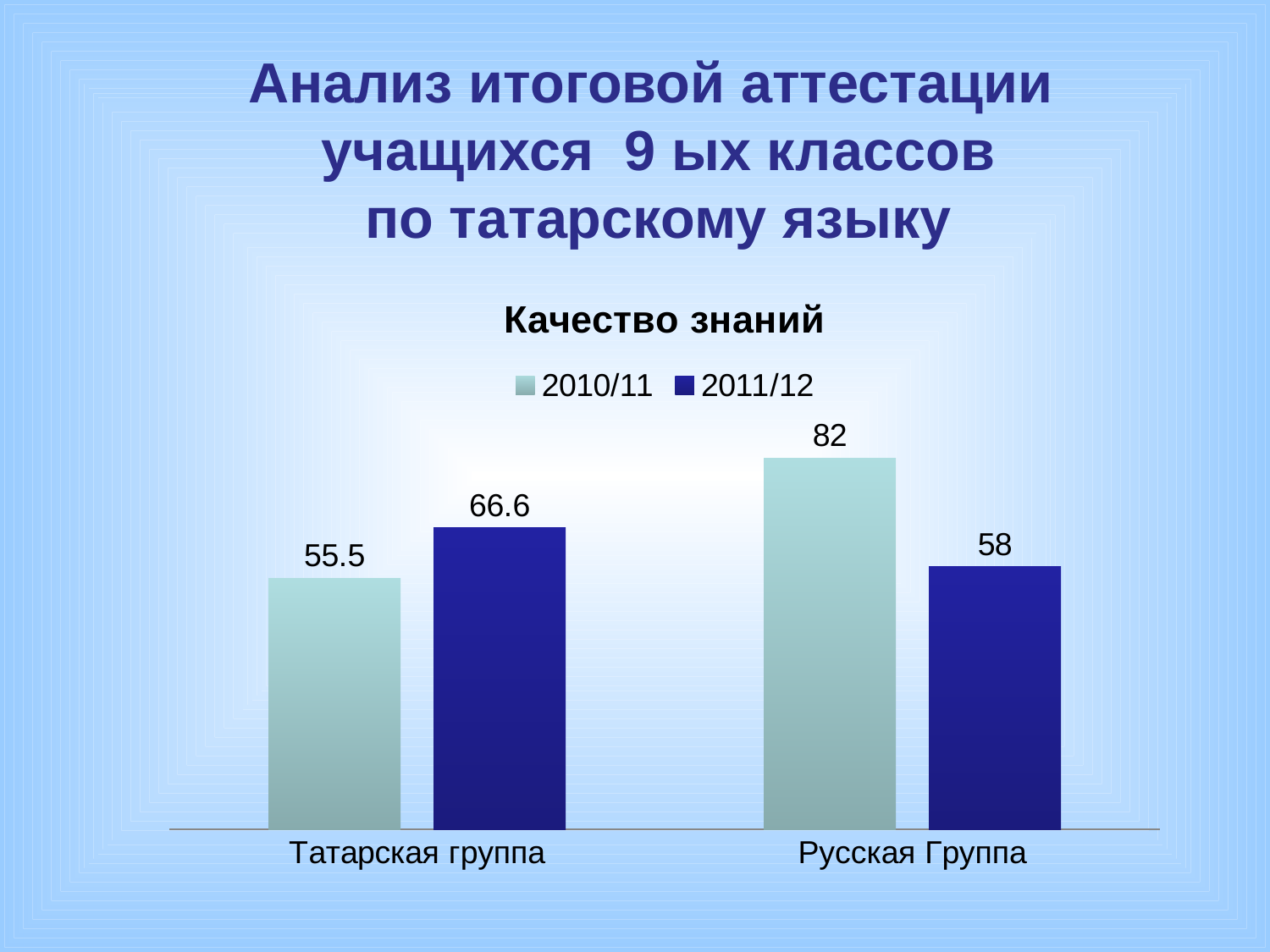
What is the difference between the 2011/12 and 2010/11 values for Татарская группа? 11.1 Which category has the lowest value in the 2011/12 series? Русская Группа Which is larger for Татарская группа: the 2010/11 value or the 2011/12 value? 2011/12 Which category has the highest value in the 2010/11 series? Русская Группа What is the value for Русская Группа in 2011/12? 58 What is the value for Татарская группа in 2010/11? 55.5 What is the value for Татарская группа in 2011/12? 66.6 What type of chart is shown on the slide? Bar chart What is the value for Русская Группа in 2010/11? 82 How many categories are shown on the x axis? 2 What is the difference between the 2010/11 and 2011/12 values for Русская Группа? 24 How many series does the legend list? 2